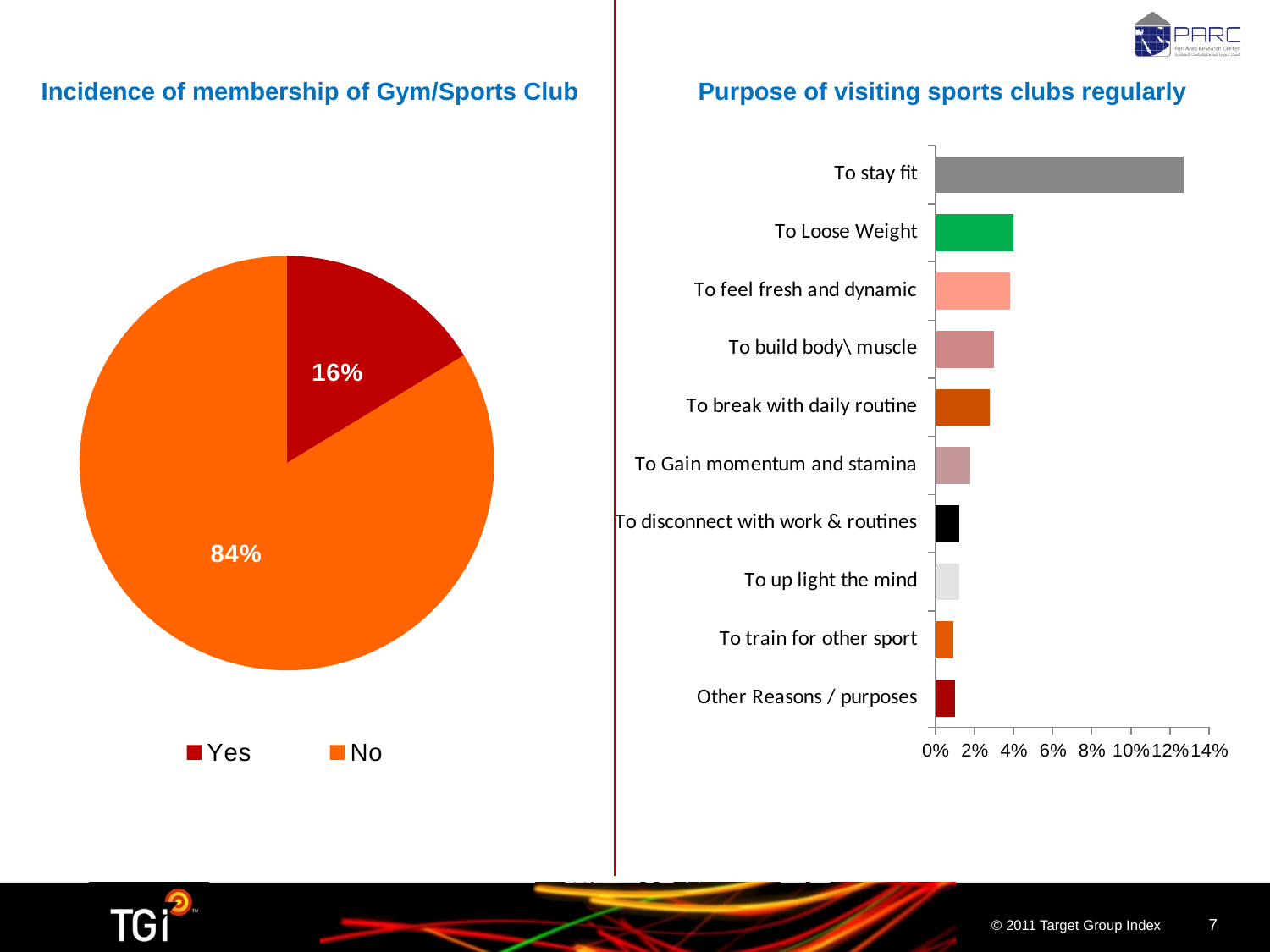
On the 'Purpose of visiting sports clubs regularly' chart, is the value for 'To build body\ muscle' greater or less than 4%? less On the 'Incidence of membership of Gym/Sports Club' chart, what is the difference in percentage points between No and Yes? 68 percentage points What kind of chart is the 'Purpose of visiting sports clubs regularly' chart? Bar chart How many entries does the legend of the 'Incidence of membership of Gym/Sports Club' chart list? 2 On the 'Purpose of visiting sports clubs regularly' chart, is the value for 'To stay fit' greater or less than 10%? greater How many purposes are listed on the 'Purpose of visiting sports clubs regularly' chart? 10 On the 'Purpose of visiting sports clubs regularly' chart, which is larger: 'To Loose Weight' or 'To Gain momentum and stamina'? To Loose Weight On the 'Incidence of membership of Gym/Sports Club' chart, what percentage answered No? 84% On the 'Incidence of membership of Gym/Sports Club' chart, what percentage answered Yes? 16% On the 'Purpose of visiting sports clubs regularly' chart, which purpose has the highest value? To stay fit What kind of chart is the 'Incidence of membership of Gym/Sports Club' chart? Pie chart